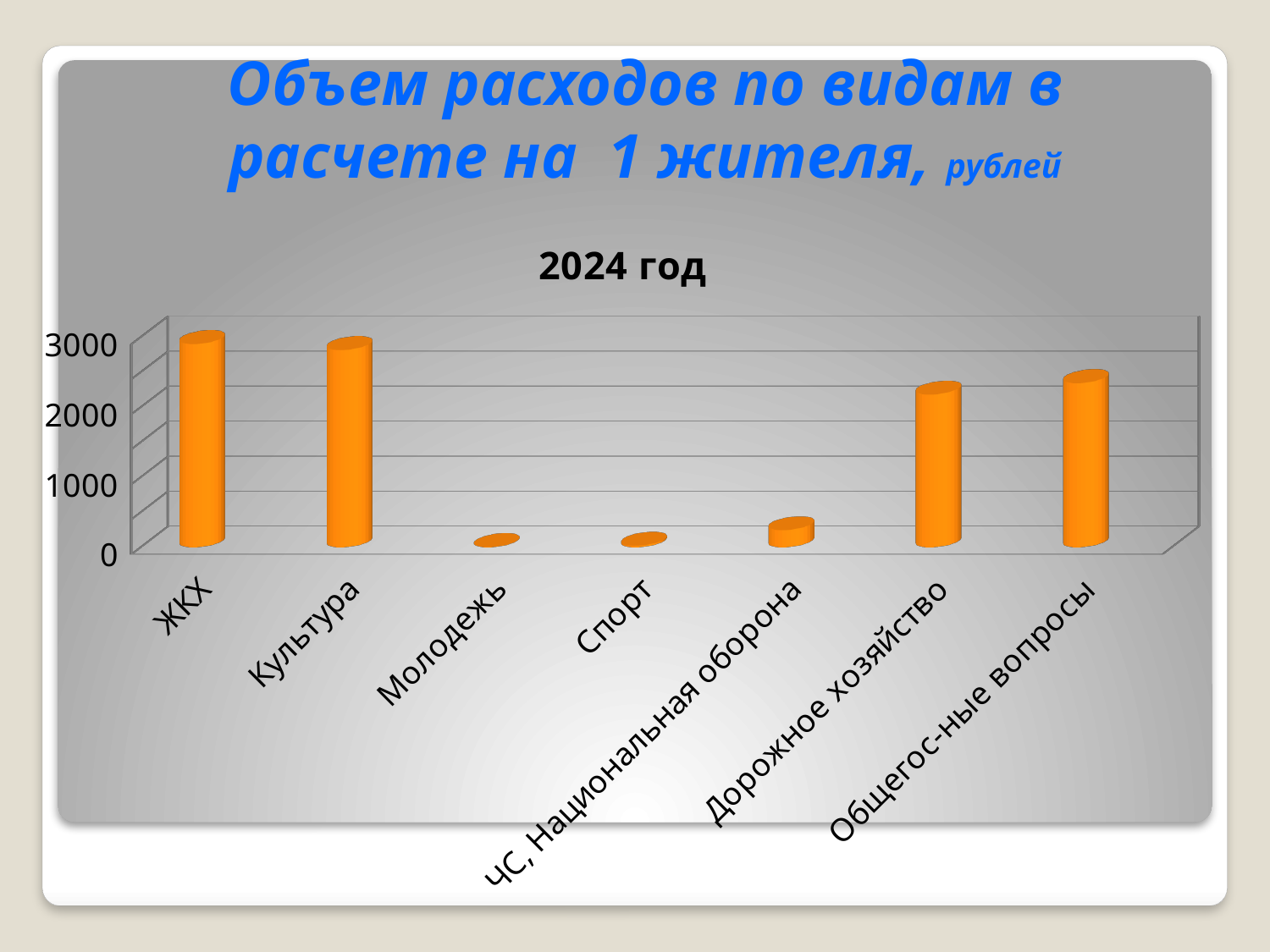
Is the value for Культура greater or less than 2000? greater Is the value for ЧС, Национальная оборона greater or less than 1000? less Which is larger, the value for Дорожное хозяйство or the value for Спорт? Дорожное хозяйство How many categories are shown on the x axis of the chart? 7 Is the value for Молодежь greater or less than 1000? less Which is larger, the value for ЖКХ or the value for Молодежь? ЖКХ What colour are the bars in the chart? orange What is the title printed directly above the chart? 2024 год What kind of chart is shown on the slide? bar chart